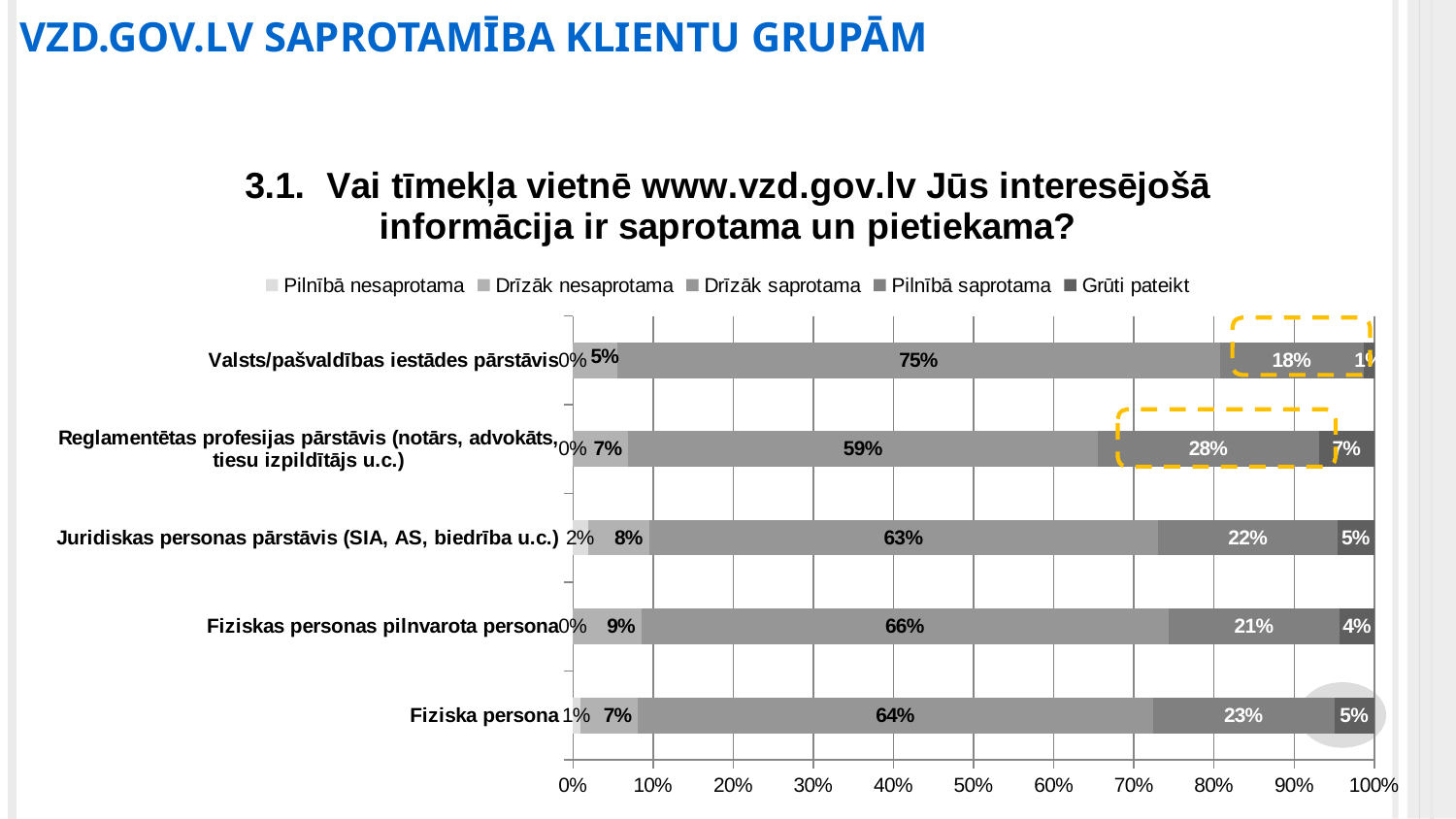
What is the 'Drīzāk nesaprotama' value for 'Fiziskas personas pilnvarota persona'? 9% How many client groups (categories) are shown in the chart? 5 What is the 'Drīzāk saprotama' value for 'Valsts/pašvaldības iestādes pārstāvis'? 75% What kind of chart is shown on the slide? Stacked bar chart Which client group has the lowest 'Drīzāk saprotama' value? Reglamentētas profesijas pārstāvis (notārs, advokāts, tiesu izpildītājs u.c.) What is the first series listed in the legend? Pilnībā nesaprotama How many series does the legend list? 5 What is the 'Grūti pateikt' value for 'Fiziska persona'? 5% Which client group has the highest 'Drīzāk saprotama' value? Valsts/pašvaldības iestādes pārstāvis What is the difference between the 'Pilnībā saprotama' values for 'Reglamentētas profesijas pārstāvis' and 'Valsts/pašvaldības iestādes pārstāvis'? 10% What is the 'Pilnībā saprotama' value for 'Reglamentētas profesijas pārstāvis (notārs, advokāts, tiesu izpildītājs u.c.)'? 28% Which is larger: the 'Drīzāk saprotama' value for 'Fiziskas personas pilnvarota persona' or for 'Juridiskas personas pārstāvis (SIA, AS, biedrība u.c.)'? Fiziskas personas pilnvarota persona